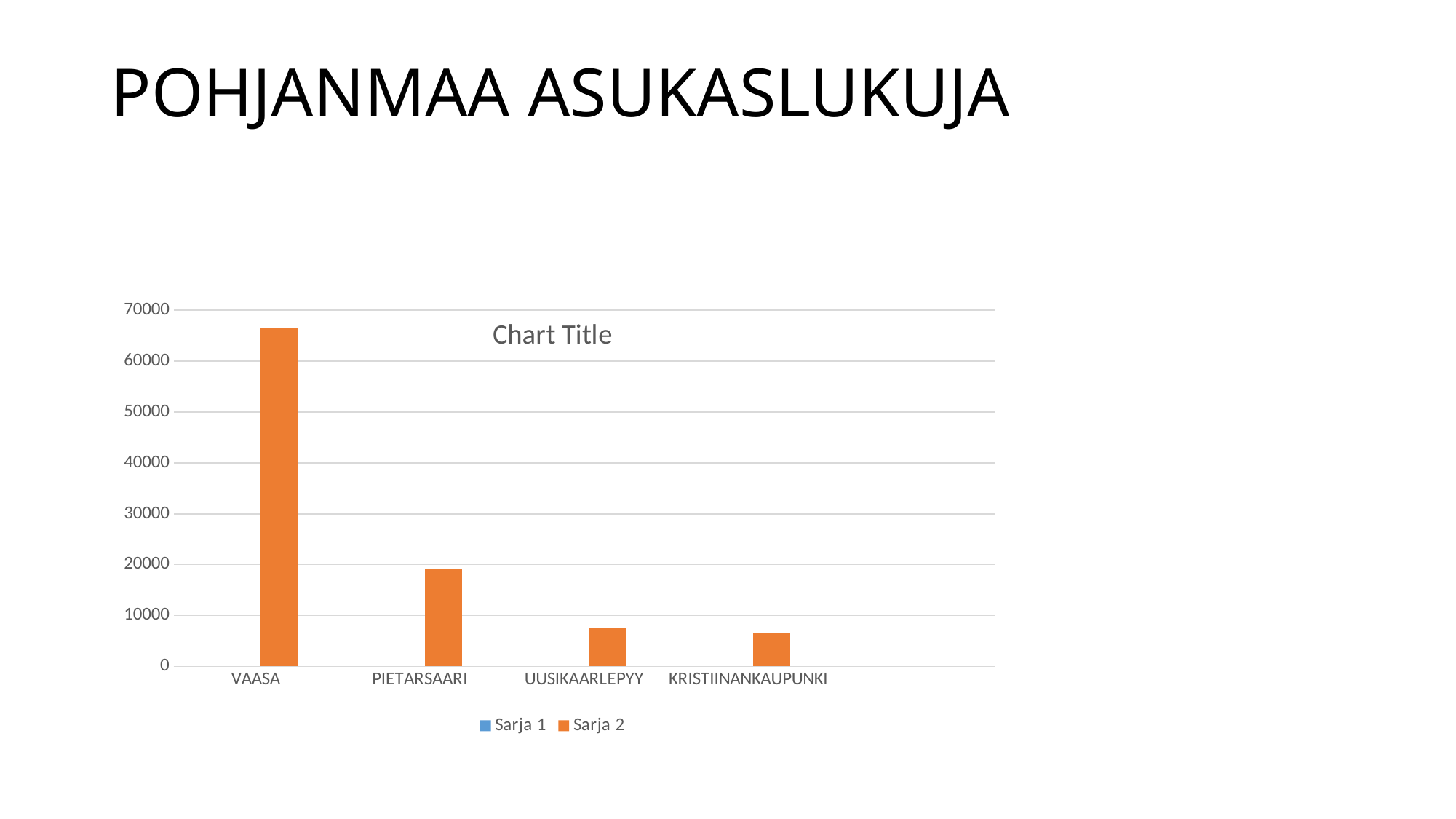
How many categories are shown on the x axis of the chart? 4 Which category has the lowest bar in the chart? KRISTIINANKAUPUNKI Which is larger, the value for VAASA or the value for PIETARSAARI? VAASA Is the value for KRISTIINANKAUPUNKI greater or less than 10000? less Is the value for UUSIKAARLEPYY greater or less than 10000? less What are the names of the series listed in the chart legend? Sarja 1, Sarja 2 Which category has the highest bar in the chart? VAASA How many series does the chart legend list? 2 Is the value for PIETARSAARI greater or less than 10000? greater What kind of chart is shown on the slide? bar chart Do the bar values rise or fall from left to right along the x axis? fall